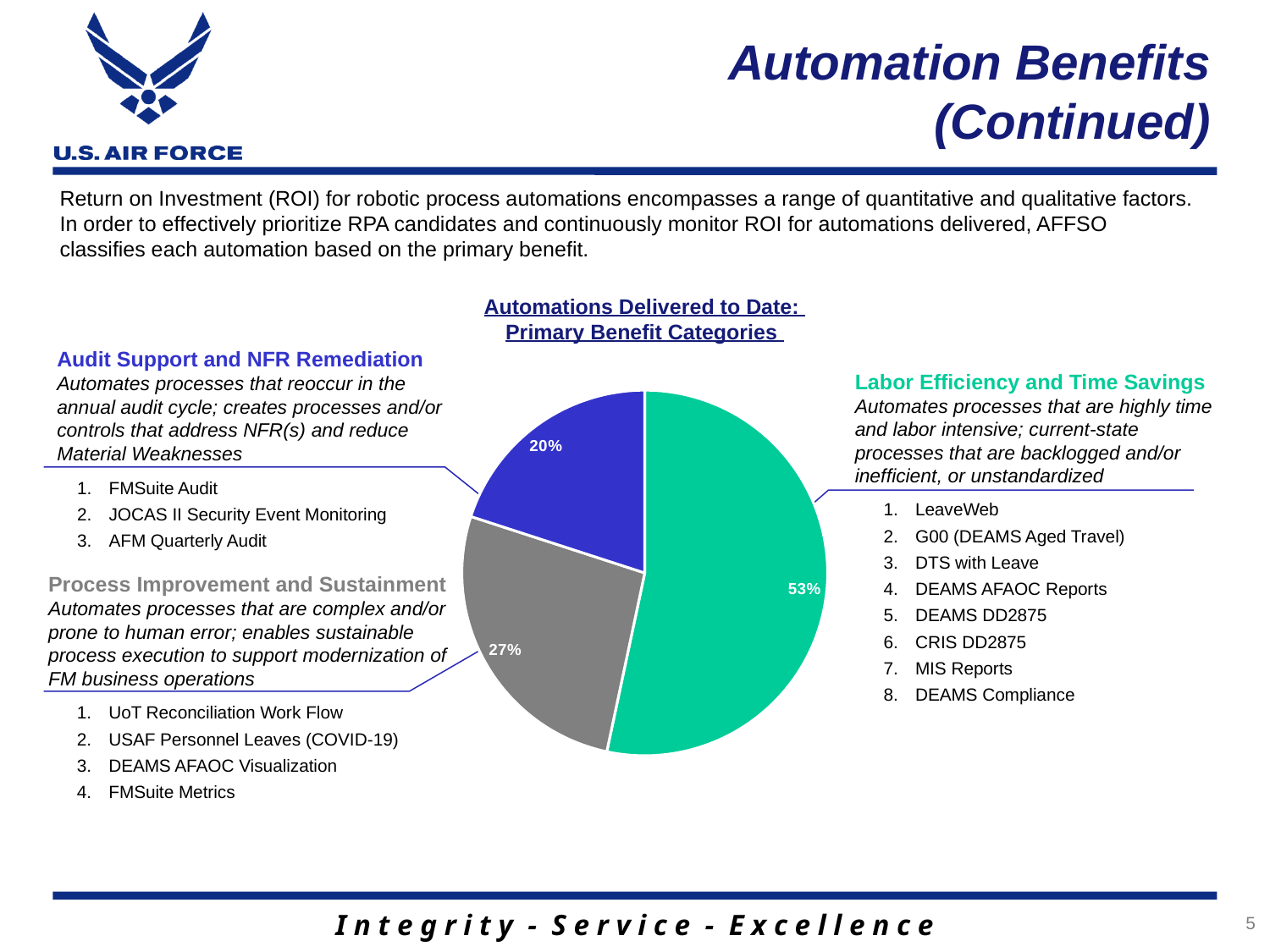
What percentage is shown for the Labor Efficiency and Time Savings slice of the pie chart? 53% What is the combined share of the Process Improvement and Sustainment and Audit Support and NFR Remediation slices? 47% Which primary benefit category has the largest share of the pie chart? Labor Efficiency and Time Savings Which primary benefit category has the smallest share of the pie chart? Audit Support and NFR Remediation What kind of chart is shown on the slide? Pie chart What is the difference in percentage points between the Labor Efficiency and Time Savings slice and the Process Improvement and Sustainment slice? 26 What percentage is shown for the Process Improvement and Sustainment slice of the pie chart? 27% Which slice is larger: Process Improvement and Sustainment or Audit Support and NFR Remediation? Process Improvement and Sustainment What percentage is shown for the Audit Support and NFR Remediation slice of the pie chart? 20% What is the title of the pie chart? Automations Delivered to Date: Primary Benefit Categories How many slices does the pie chart have? 3 What colour is the slice representing Labor Efficiency and Time Savings in the pie chart? Green